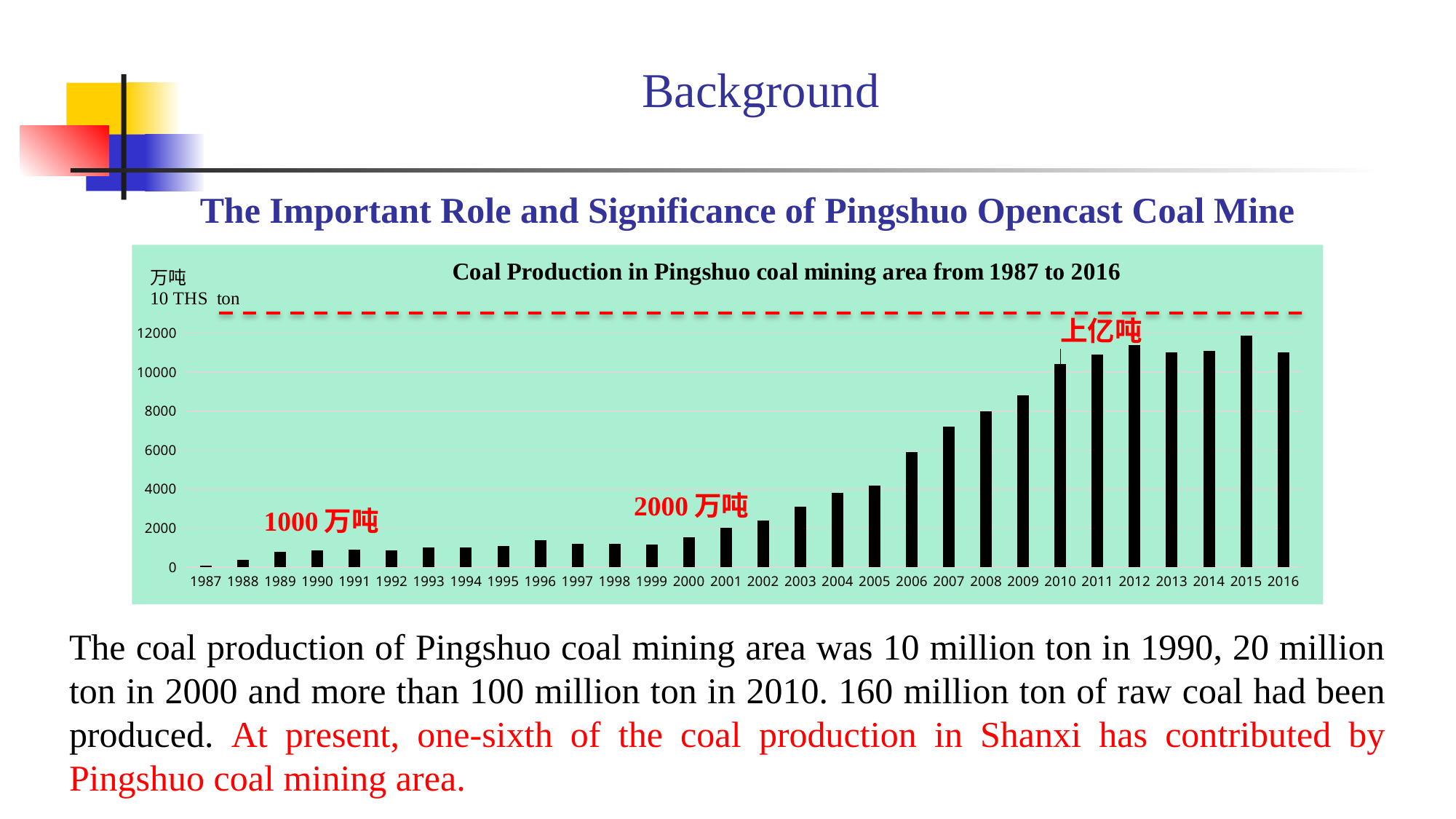
Is the value for 2003 greater or less than 2000? greater Which year has the highest coal production in the chart? 2015 How many years (bars) are plotted in the chart? 30 What kind of chart is shown on the slide? bar chart Is the value for 2015 greater or less than 10000? greater Is the value for 2009 greater or less than 8000? greater Which year has the larger coal production, 2008 or 2009? 2009 What is the title of the chart? Coal Production in Pingshuo coal mining area from 1987 to 2016 Which year has the lowest coal production in the chart? 1987 Overall, does coal production rise or fall from 1987 to 2016? rise Which year has the larger coal production, 2015 or 2016? 2015